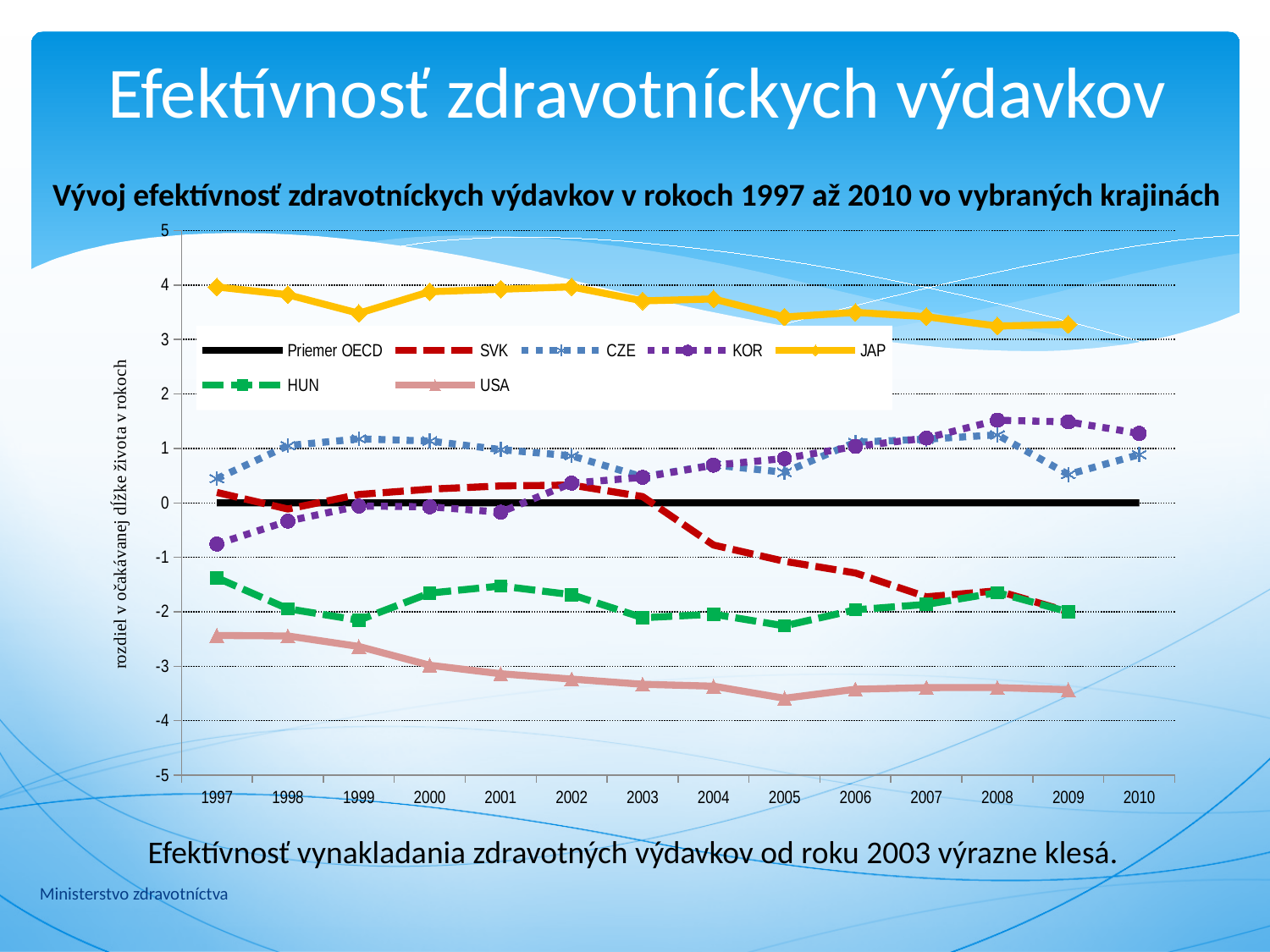
In 2008, which series has the higher value, KOR or CZE? KOR Does the KOR line rise or fall from 1997 to 2010? rise Does the SVK line rise or fall from 2003 to 2009? fall Is the value for JAP in 1997 greater or less than 3? greater Which series has the highest value in 1997? JAP What kind of chart is shown on the slide? line chart What is the label of the y axis? rozdiel v očakávanej dĺžke života v rokoch Which series has the lowest value in 2009? USA How many years are shown on the x axis? 14 Is the value for HUN in 2005 greater or less than -2? less How many series does the legend list? 7 Is the value for USA in 2005 greater or less than -3? less